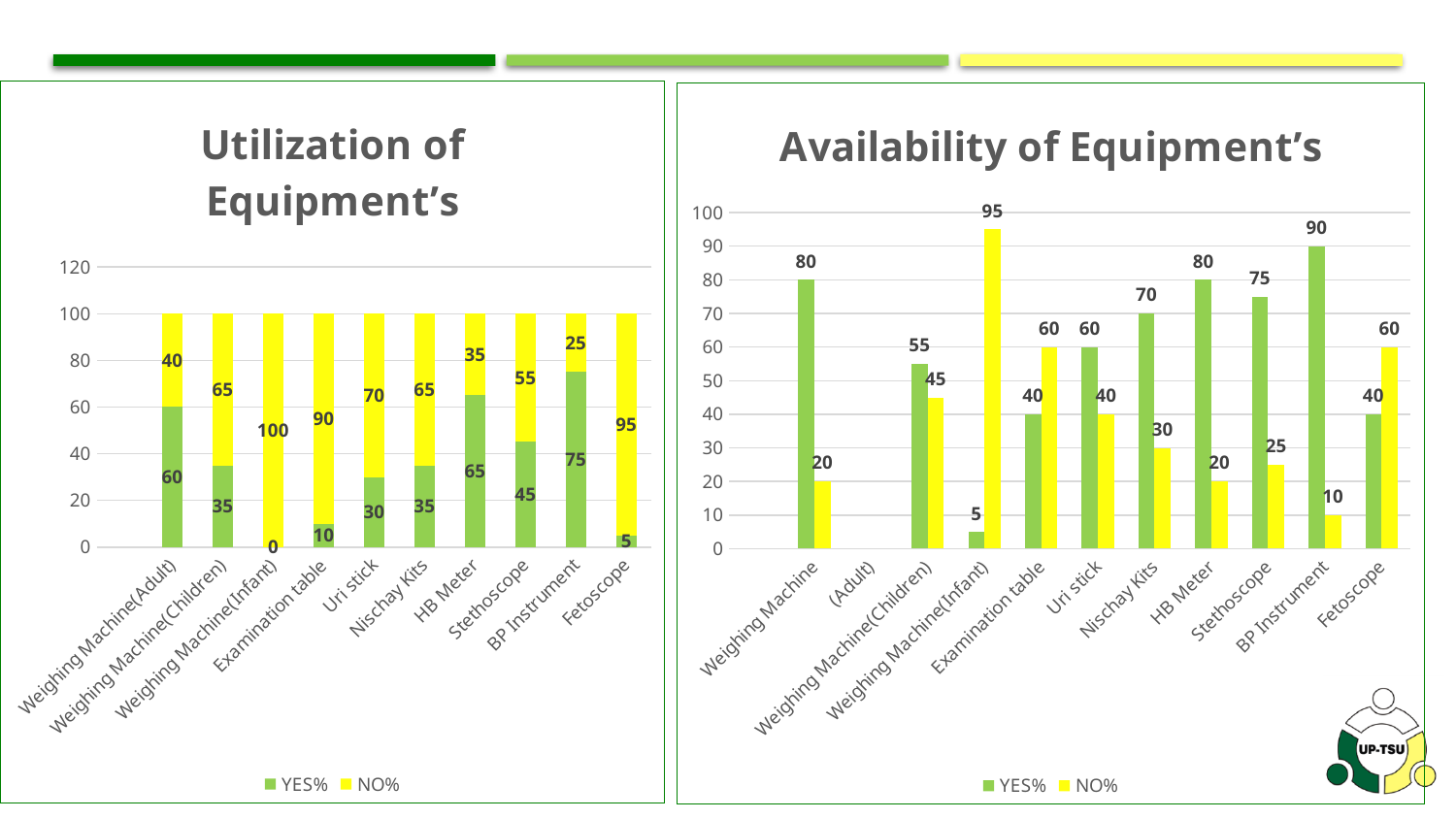
In the Availability of Equipment's chart, which is larger for Examination table, YES% or NO%? NO% In the Availability of Equipment's chart, what is the difference between the YES% and NO% values for Nischay Kits? 40 How many series does the legend of the Availability of Equipment's chart list? 2 In the Utilization of Equipment's chart, what is the total of the stacked bar for Stethoscope? 100 In the Utilization of Equipment's chart, what is the YES% value for HB Meter? 65 In the Utilization of Equipment's chart, which category has the lowest YES% value? Weighing Machine(Infant) In the Utilization of Equipment's chart, how many categories are shown on the x axis? 10 In the Availability of Equipment's chart, what is the NO% value for Weighing Machine(Infant)? 95 In the Utilization of Equipment's chart, which category has the highest YES% value? BP Instrument In the Utilization of Equipment's chart, what is the NO% value for Fetoscope? 95 In the Availability of Equipment's chart, what is the YES% value for BP Instrument? 90 What kind of chart is the Utilization of Equipment's chart? Stacked bar chart